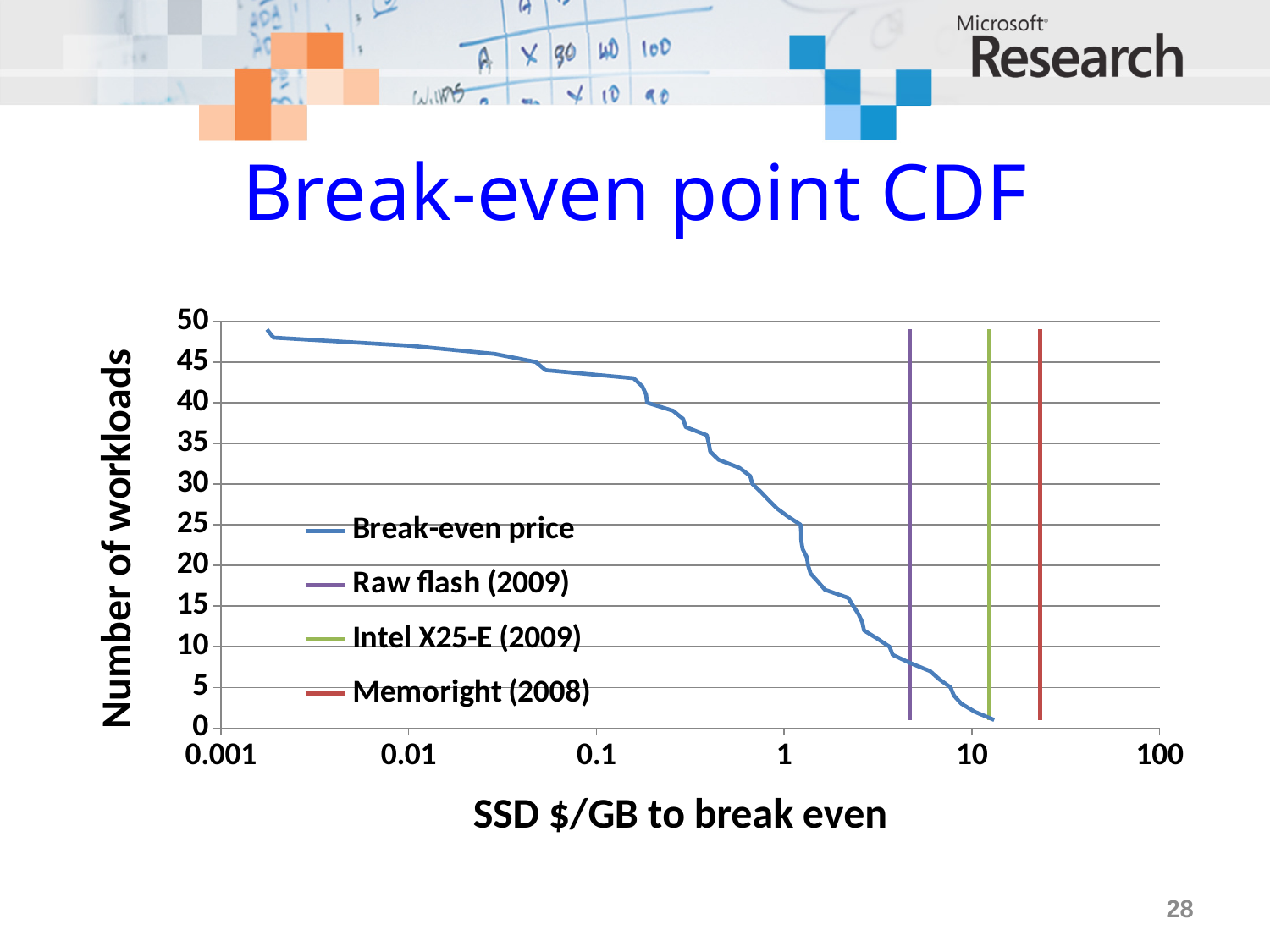
Is the SSD $/GB value of the Memoright (2008) line greater or less than 10? greater Is the SSD $/GB value of the Raw flash (2009) line greater or less than 1? greater What is the title of the chart on the slide? Break-even point CDF Is the SSD $/GB value of the Raw flash (2009) line greater or less than 10? less Which legend entry is drawn as the vertical line furthest to the left on the chart? Raw flash (2009) Does the Break-even price curve rise or fall as the SSD $/GB value increases along the x axis? fall What kind of chart is shown on the slide? line chart How many series does the legend list? 4 Which legend entry is drawn as the vertical line furthest to the right on the chart? Memoright (2008) What is the label of the x axis? SSD $/GB to break even